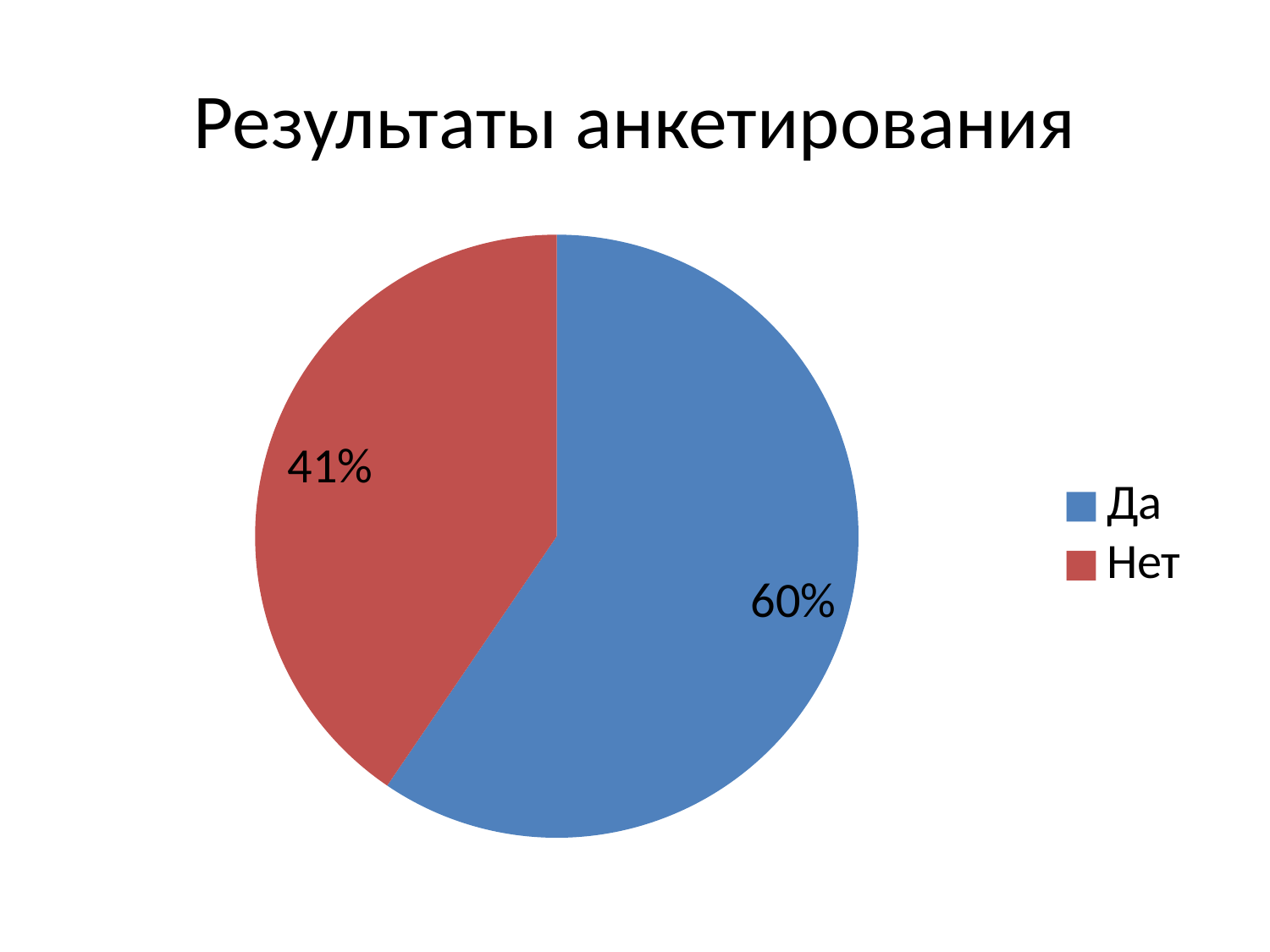
What kind of chart is shown on the slide? pie chart How many entries does the legend list? 2 What is the title of the chart? Результаты анкетирования What is the value shown for the "Нет" slice? 41% How many slices does the pie chart have? 2 What is the difference between the "Да" and "Нет" values? 19% What is the value shown for the "Да" slice? 60% Which is larger, the "Да" slice or the "Нет" slice? Да What colour is the "Нет" slice? red Which slice is the smallest? Нет Which slice is the largest? Да